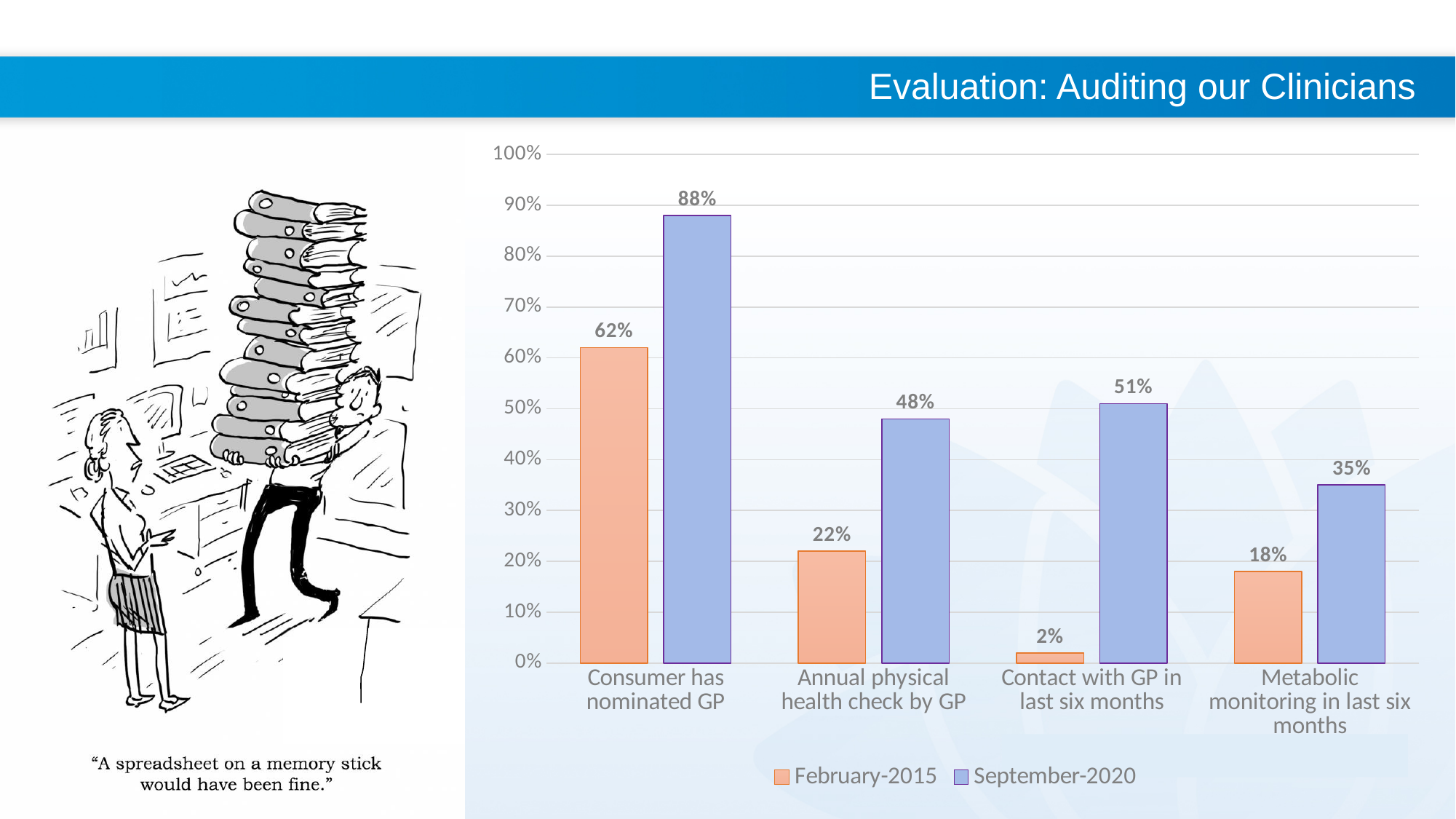
What is the difference between the September-2020 and February-2015 values for "Contact with GP in last six months"? 49% How many categories are shown on the x axis? 4 Which category has the lowest February-2015 value? Contact with GP in last six months What is the September-2020 value for "Annual physical health check by GP"? 48% Which is larger: the February-2015 value for "Consumer has nominated GP" or the September-2020 value for "Contact with GP in last six months"? February-2015 value for Consumer has nominated GP How many series does the legend list? 2 What is the February-2015 value for "Contact with GP in last six months"? 2% What is the September-2020 value for "Consumer has nominated GP"? 88% Which series is shown in orange in the legend? February-2015 Which category has the highest September-2020 value? Consumer has nominated GP What is the February-2015 value for "Metabolic monitoring in last six months"? 18% What kind of chart is shown on the slide? Bar chart